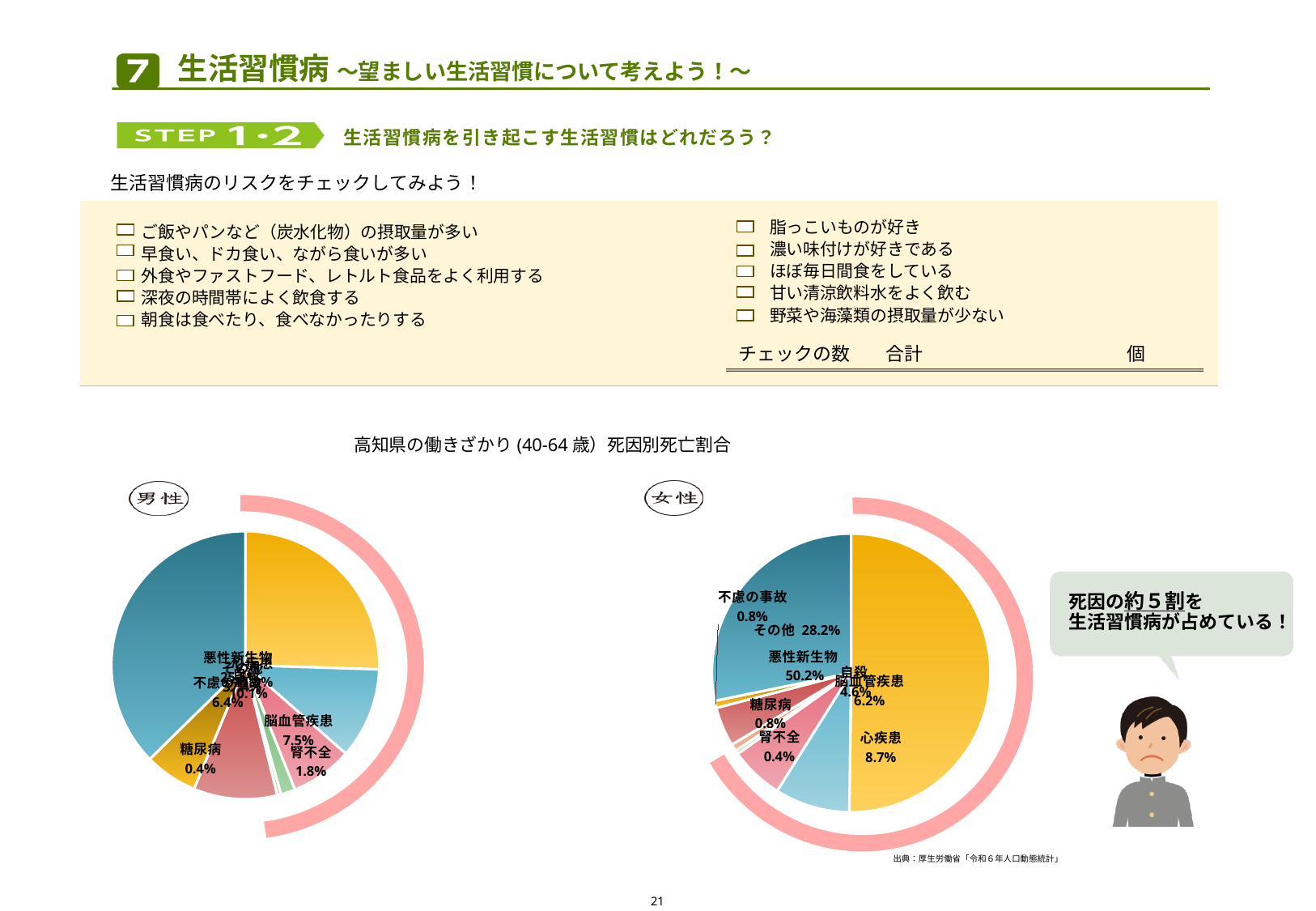
In the 女性 pie chart, which is larger: the share for 脳血管疾患 or the share for 自殺? 脳血管疾患 In the 女性 pie chart, what percentage is shown for 心疾患? 8.7% How many slices are labelled in the 女性 pie chart? 8 In the 女性 pie chart, what percentage is shown for 悪性新生物? 50.2% In the 女性 pie chart, which cause of death has the largest share? 悪性新生物 In the 男性 pie chart, what percentage is shown for 腎不全? 1.8% In the 女性 pie chart, what percentage is shown for その他? 28.2% In the 女性 pie chart, which cause of death has the smallest share? 腎不全 What type of chart is used to show the 死因別死亡割合 for 男性 and 女性? Pie chart In the 女性 pie chart, what is the difference between the shares for 心疾患 and 脳血管疾患? 2.5% In the 女性 pie chart, what percentage is shown for 自殺? 4.6% In the 男性 pie chart, what percentage is shown for 脳血管疾患? 7.5%